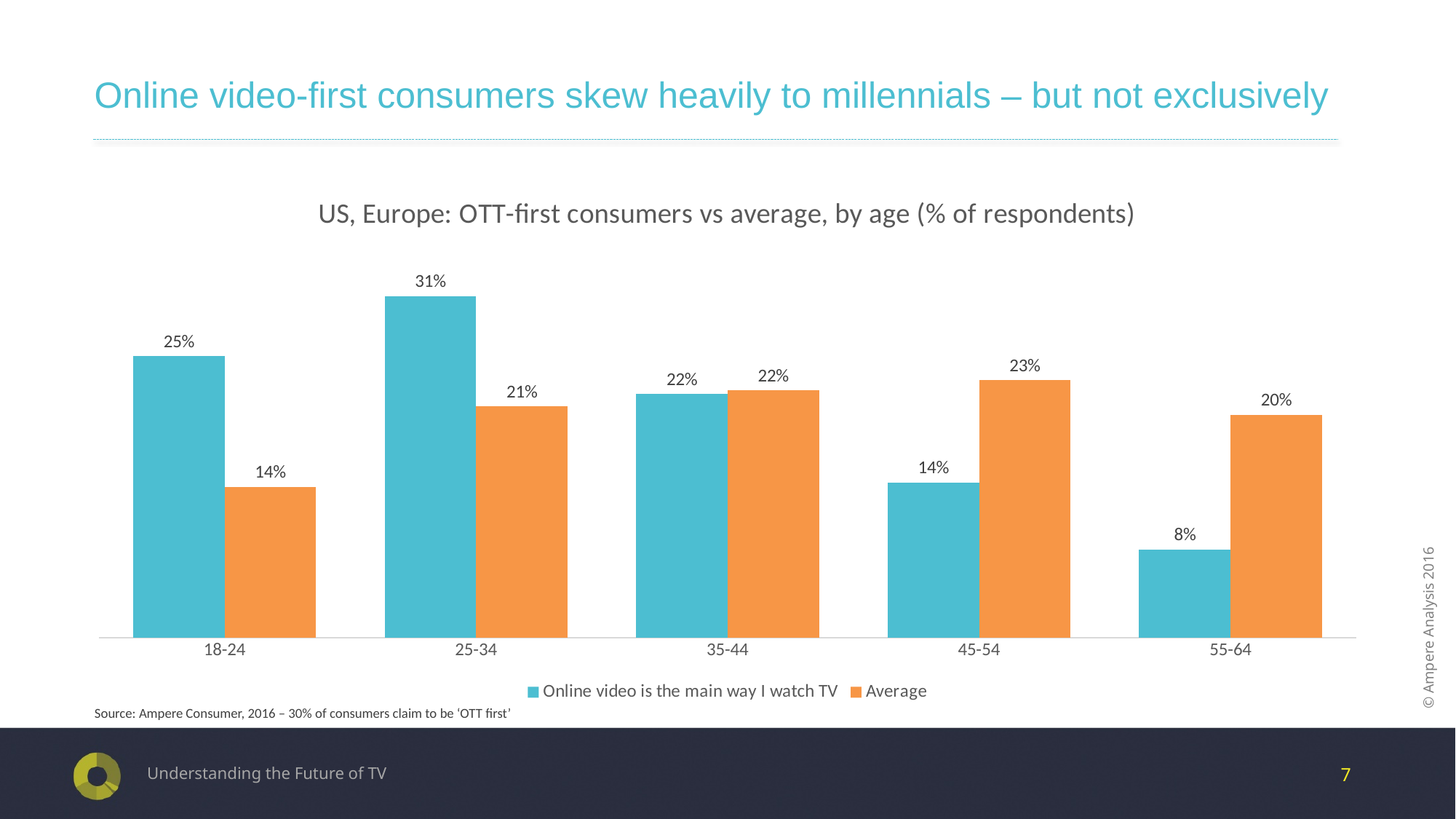
What is the title of the chart? US, Europe: OTT-first consumers vs average, by age (% of respondents) What is the value for 'Online video is the main way I watch TV' in the 55-64 age group? 8% For the 45-54 age group, which is larger: 'Online video is the main way I watch TV' or 'Average'? Average Which age group has the highest value for 'Online video is the main way I watch TV'? 25-34 How many series does the legend list? 2 What kind of chart is shown on the slide? Bar chart What is the difference between the 'Online video is the main way I watch TV' value and the 'Average' value for the 25-34 age group? 10% What is the value for 'Online video is the main way I watch TV' in the 25-34 age group? 31% Which age group has the lowest 'Average' value? 18-24 What is the 'Average' value for the 18-24 age group? 14% How many age groups are shown on the x axis? 5 Does the 'Average' series rise or fall from the 35-44 age group to the 45-54 age group? Rise